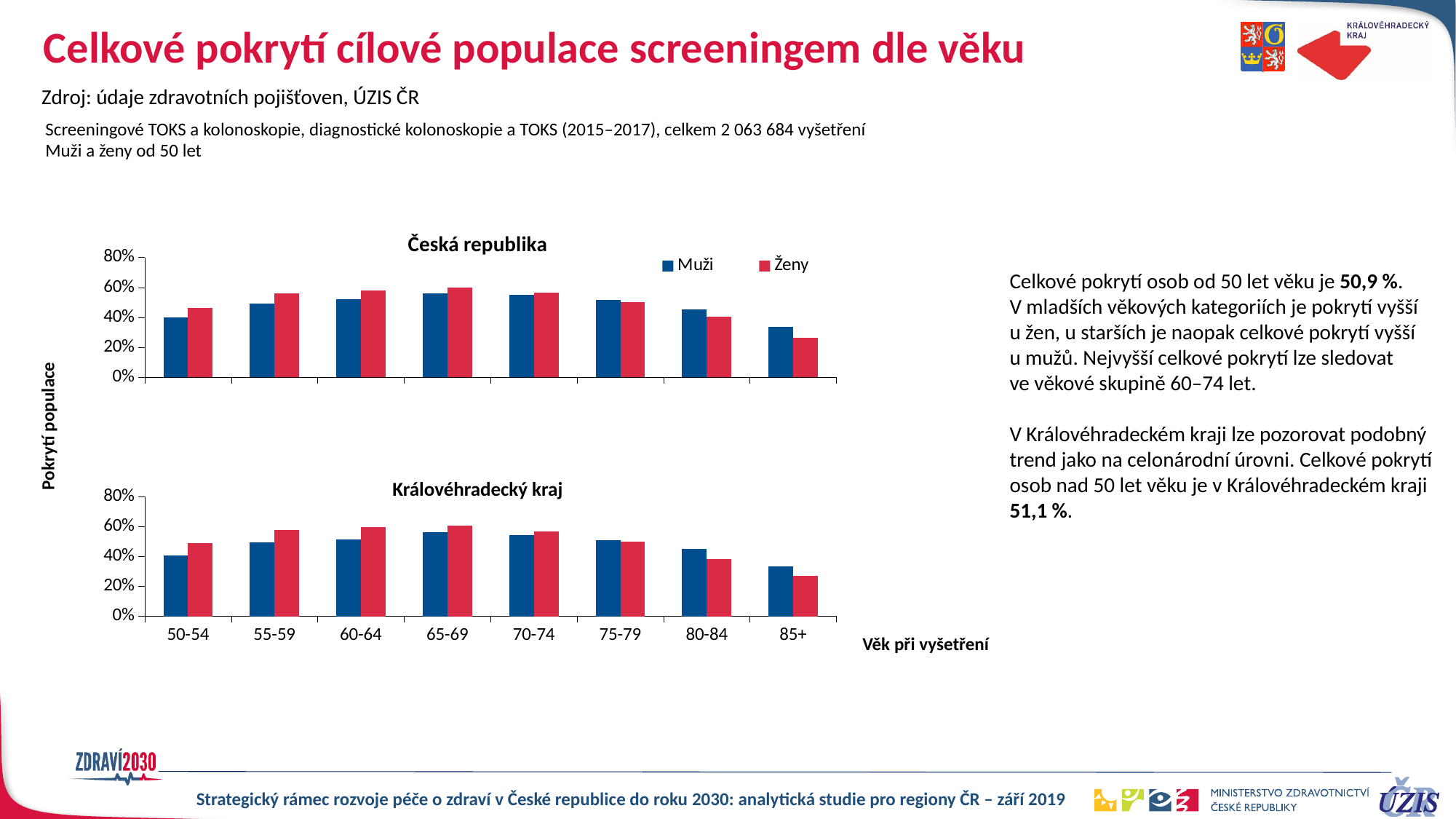
In the "Česká republika" chart, is the value for Muži in the 80-84 age group greater or less than 40%? greater How many age categories are shown on the x axis of the "Královéhradecký kraj" chart? 8 In the "Královéhradecký kraj" chart, for the 50-54 age group, which is larger: Muži or Ženy? Ženy In the "Královéhradecký kraj" chart, is the value for Ženy in the 50-54 age group greater or less than 40%? greater In the "Královéhradecký kraj" chart, is the value for Ženy in the 85+ age group greater or less than 20%? greater What kind of chart is the "Česká republika" chart? bar chart How many series does the legend of the "Česká republika" chart list? 2 In the "Česká republika" chart, which age group has the lowest value for Ženy? 85+ In the "Královéhradecký kraj" chart, which age group has the lowest value for Muži? 85+ What is the label of the x axis shared by the two charts? Věk při vyšetření In the "Česká republika" chart, for the 85+ age group, which is larger: Muži or Ženy? Muži